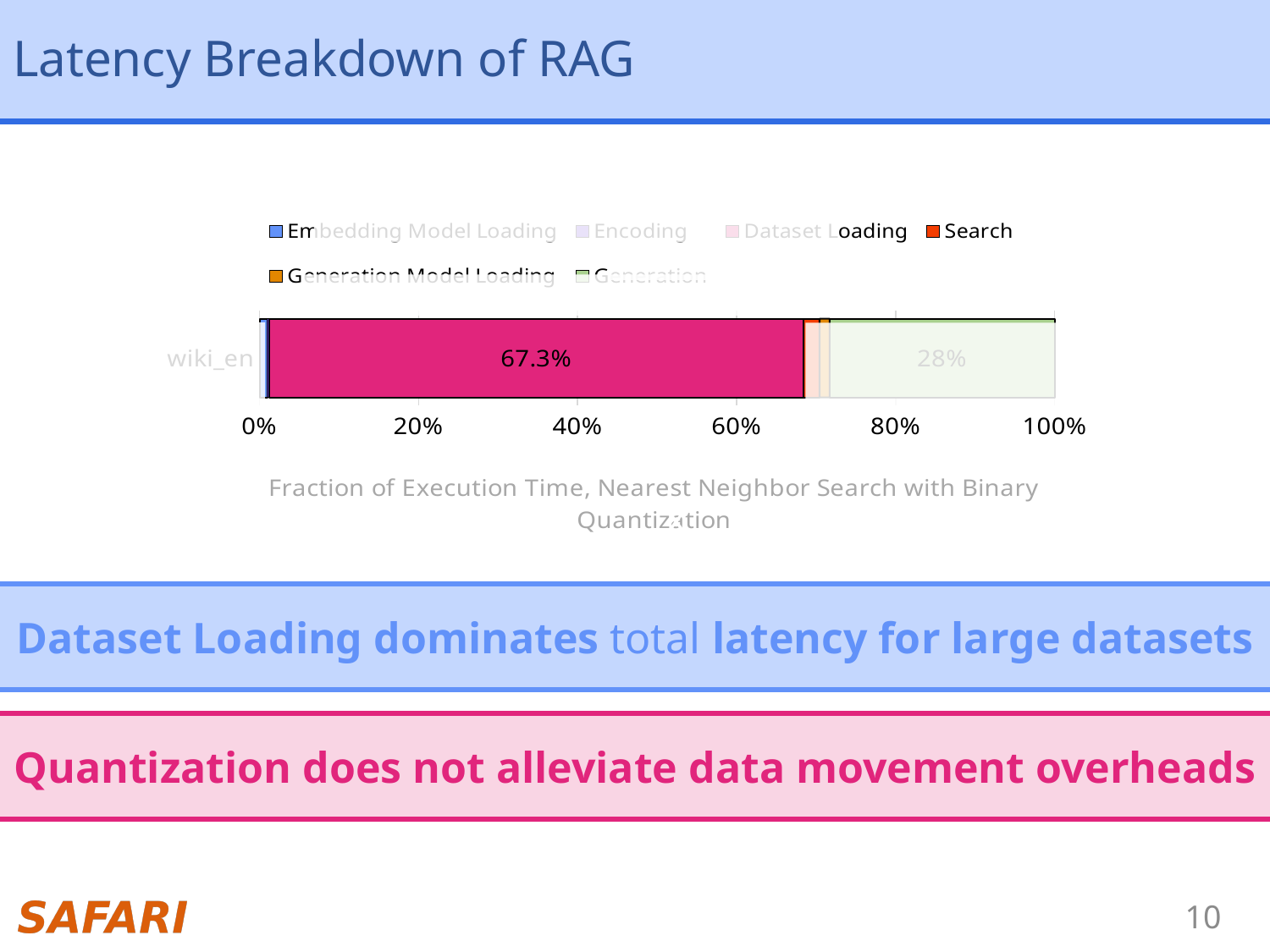
What is the x-axis title of the chart? Fraction of Execution Time, Nearest Neighbor Search with Binary Quantization How many categories are plotted on the y axis? 1 Is the Dataset Loading fraction for wiki_en greater or less than 60%? greater Which series takes the largest share of execution time for wiki_en? Dataset Loading What fraction of execution time does Dataset Loading take for wiki_en? 67.3% Which is larger for wiki_en, Dataset Loading or Generation? Dataset Loading What is the label of the single category on the y axis? wiki_en Is the Generation fraction for wiki_en greater or less than 40%? less What kind of chart is shown on the slide? bar chart What is the difference between the Dataset Loading and Generation fractions for wiki_en? 39.3% What fraction of execution time does Generation take for wiki_en? 28% How many series does the legend list? 6